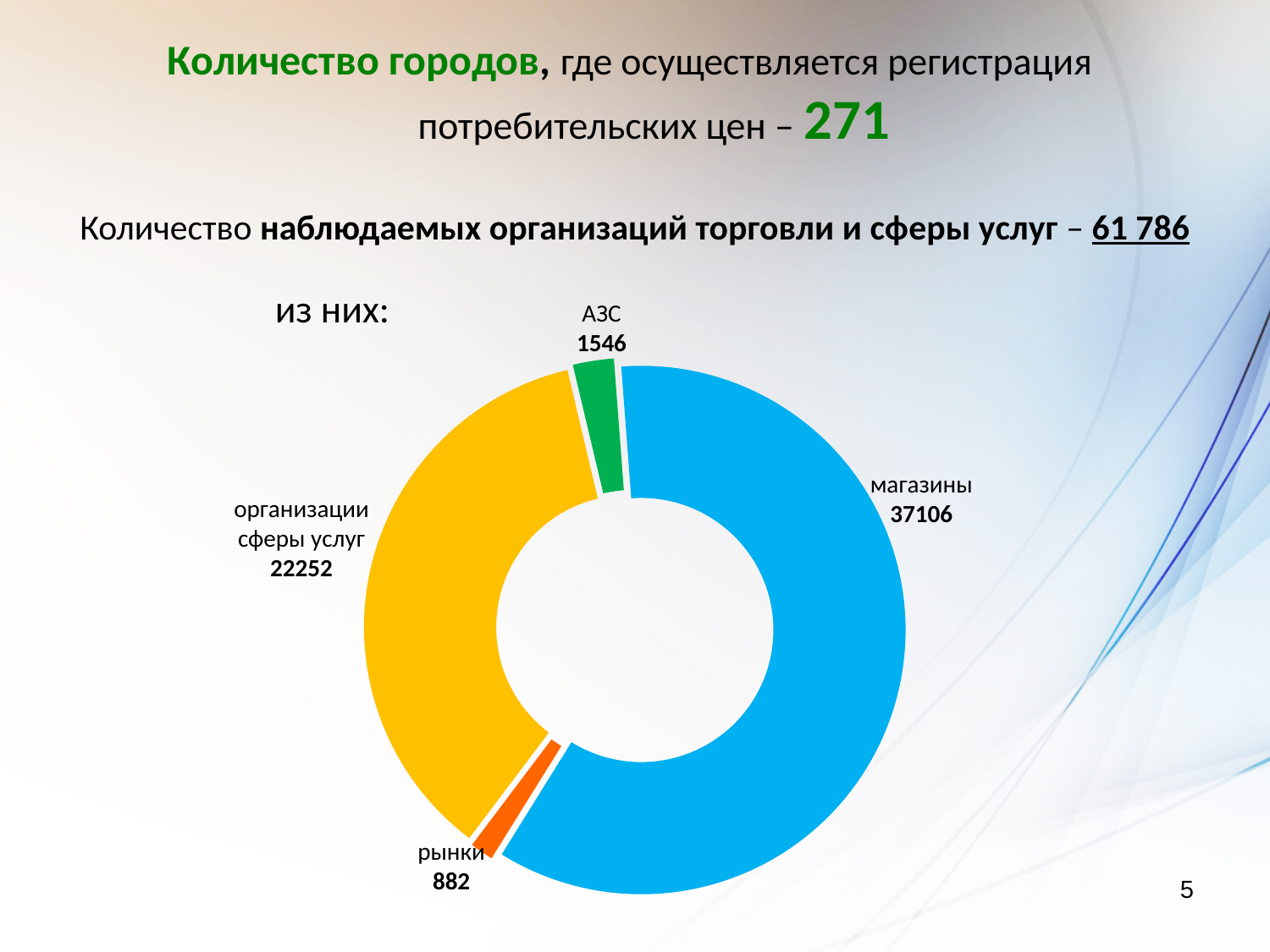
What is the difference between АЗС and рынки? 664 Which category has the smallest value? рынки What is the value for магазины? 37106 What is the value for рынки? 882 What is the value for организации сферы услуг? 22252 How many categories does the doughnut chart show? 4 What is the value for АЗС? 1546 Which is larger, АЗС or рынки? АЗС What is the difference between магазины and организации сферы услуг? 14854 What kind of chart is shown on the slide? Doughnut (pie) chart Which category has the largest value? магазины What is the total of all four categories in the chart? 61786